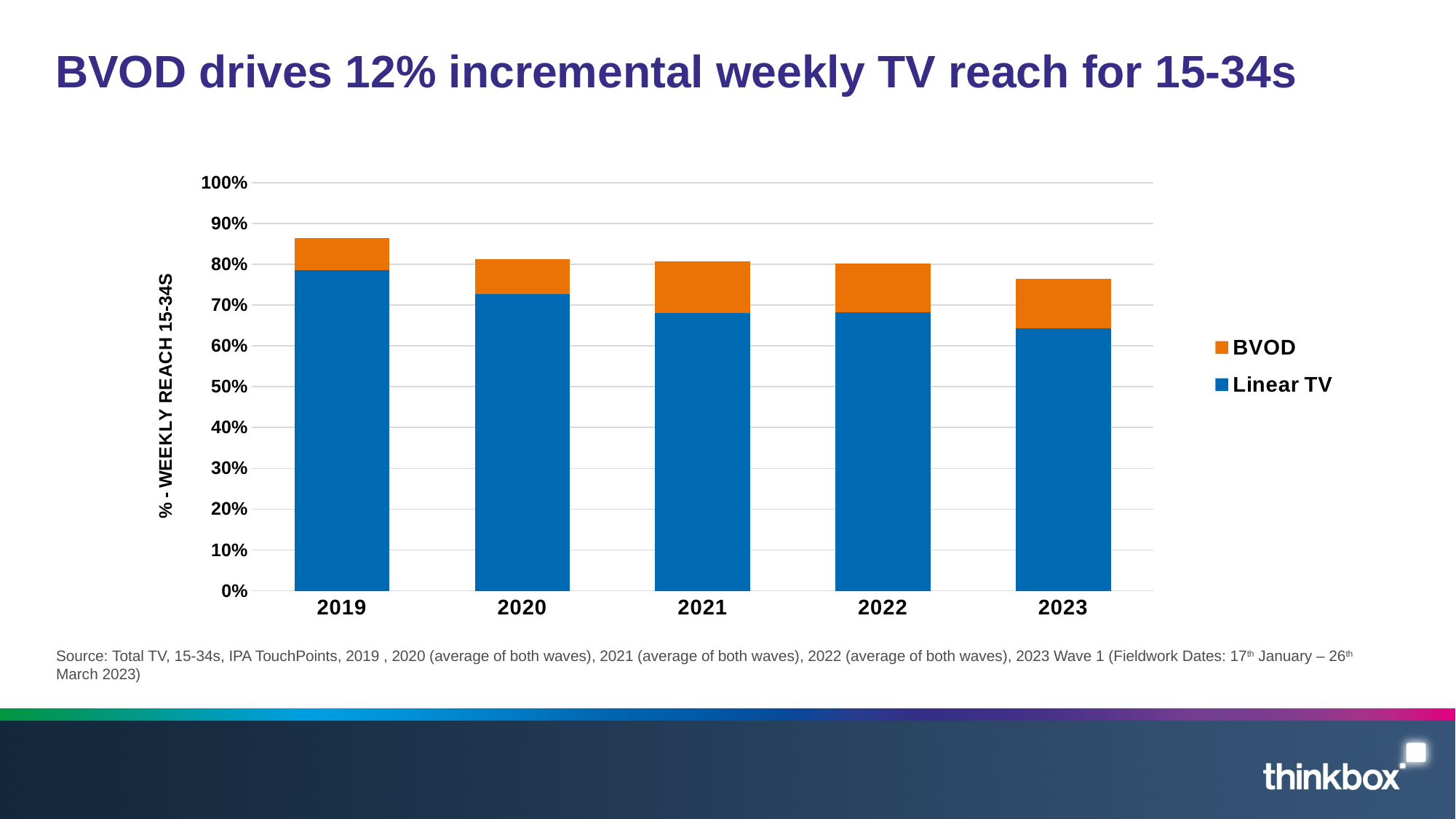
Is the Linear TV reach for 2023 greater or less than 70%? less Is the total weekly reach for 2023 greater or less than 80%? less Does Linear TV reach rise or fall from 2019 to 2023? Fall Which year has the lowest Linear TV reach? 2023 Which year has the highest Linear TV reach? 2019 What kind of chart is shown on the slide? Stacked bar chart Which series is shown in orange? BVOD Is the Linear TV reach for 2019 greater or less than 70%? greater Which year has the lowest total weekly TV reach? 2023 Which year has the highest total weekly TV reach? 2019 How many series does the legend list? 2 How many years are shown on the x axis? 5